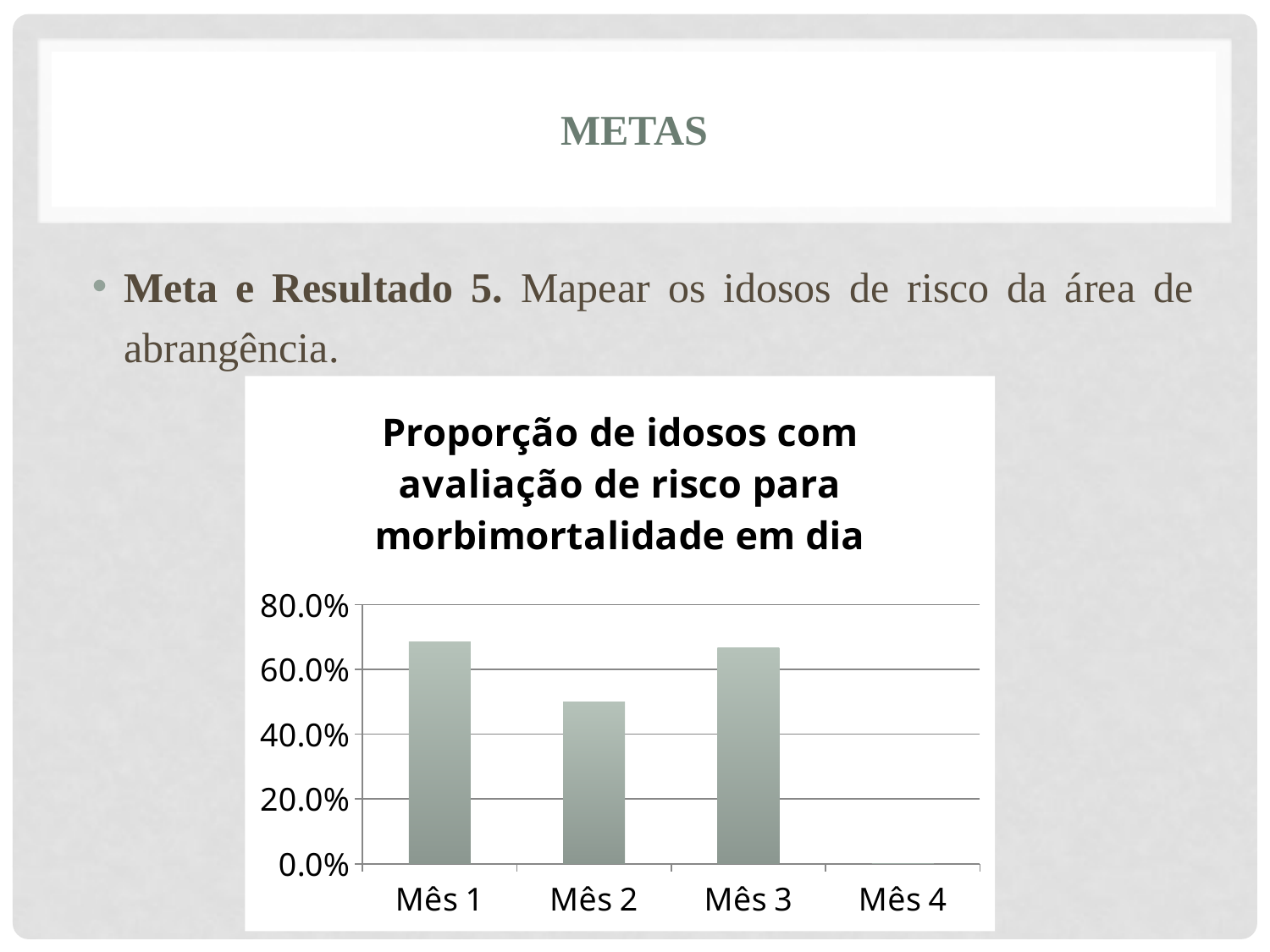
Is the value for Mês 3 greater or less than 60.0%? greater Is the value for Mês 2 greater or less than 40.0%? greater Which is larger, the value for Mês 2 or the value for Mês 3? Mês 3 Is the value for Mês 1 greater or less than 80.0%? less What is the title of the chart? Proporção de idosos com avaliação de risco para morbimortalidade em dia Does the value rise or fall from Mês 1 to Mês 2? fall How many categories are shown on the x axis of the chart? 4 What kind of chart is shown on the slide? bar chart Which is larger, the value for Mês 1 or the value for Mês 2? Mês 1 What is the highest tick value shown on the vertical axis of the chart? 80.0%